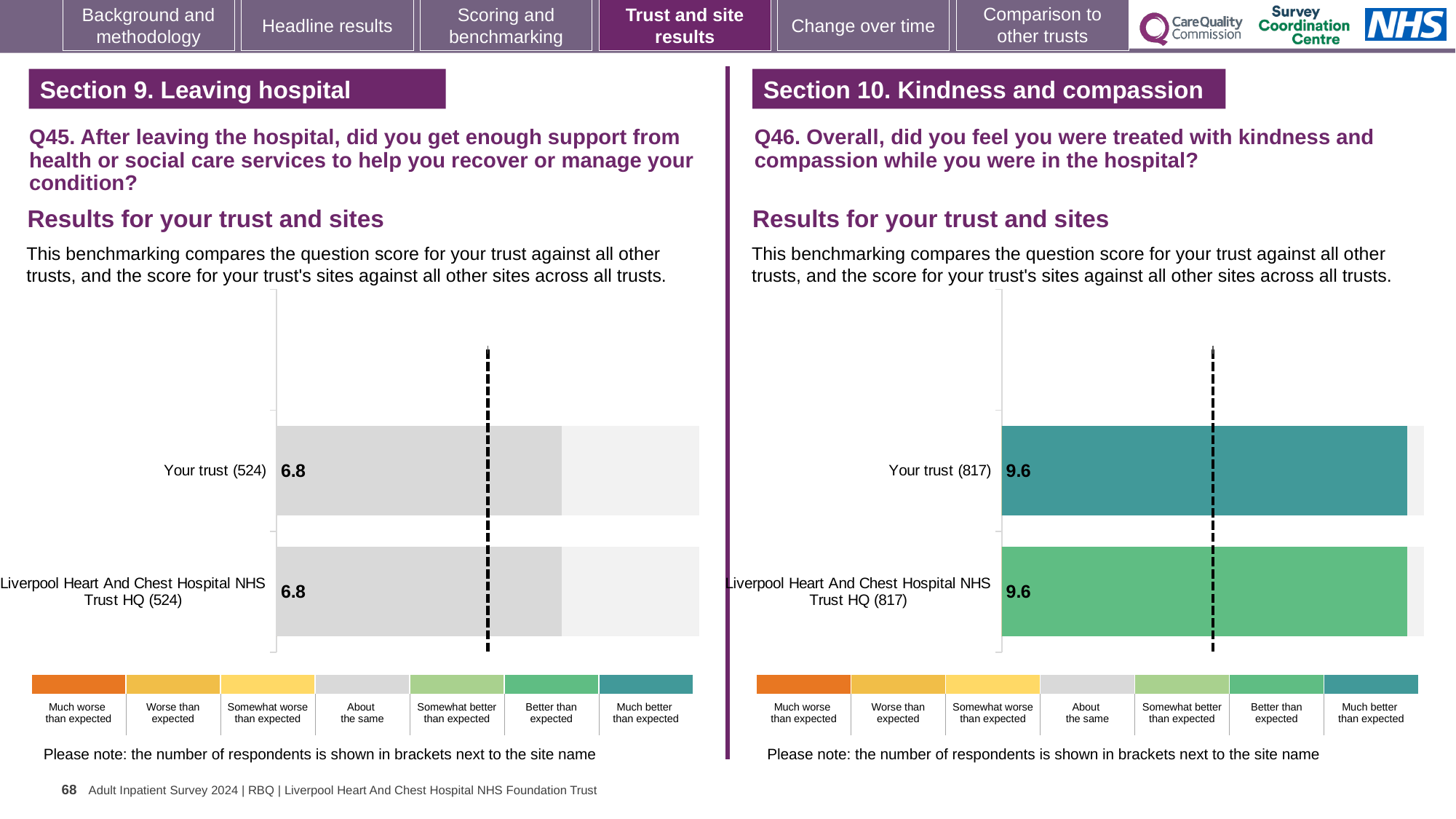
On the Q46 chart (right), how many bars are plotted? 2 On the Q46 chart (right), what is the score for Liverpool Heart And Chest Hospital NHS Trust HQ? 9.6 On the Q45 chart (left), what is the difference between the Your trust score and the Liverpool Heart And Chest Hospital NHS Trust HQ score? 0 Is the Your trust score on the Q46 chart (right) larger or smaller than the Your trust score on the Q45 chart (left)? Larger On the Q45 chart (left), how many respondents are shown in brackets for Your trust? 524 On the Q46 chart (right), what is the score for Your trust? 9.6 On the Q46 chart (right), which benchmark category does the colour of the Your trust bar correspond to? Much better than expected On the Q46 chart (right), how many respondents are shown in brackets for Liverpool Heart And Chest Hospital NHS Trust HQ? 817 What kind of chart is used on the Q45 chart (left)? Bar chart On the Q45 chart (left), what is the score for Liverpool Heart And Chest Hospital NHS Trust HQ? 6.8 On the Q45 chart (left), which benchmark category does the colour of the Your trust bar correspond to? About the same On the Q45 chart (left), what is the score for Your trust? 6.8